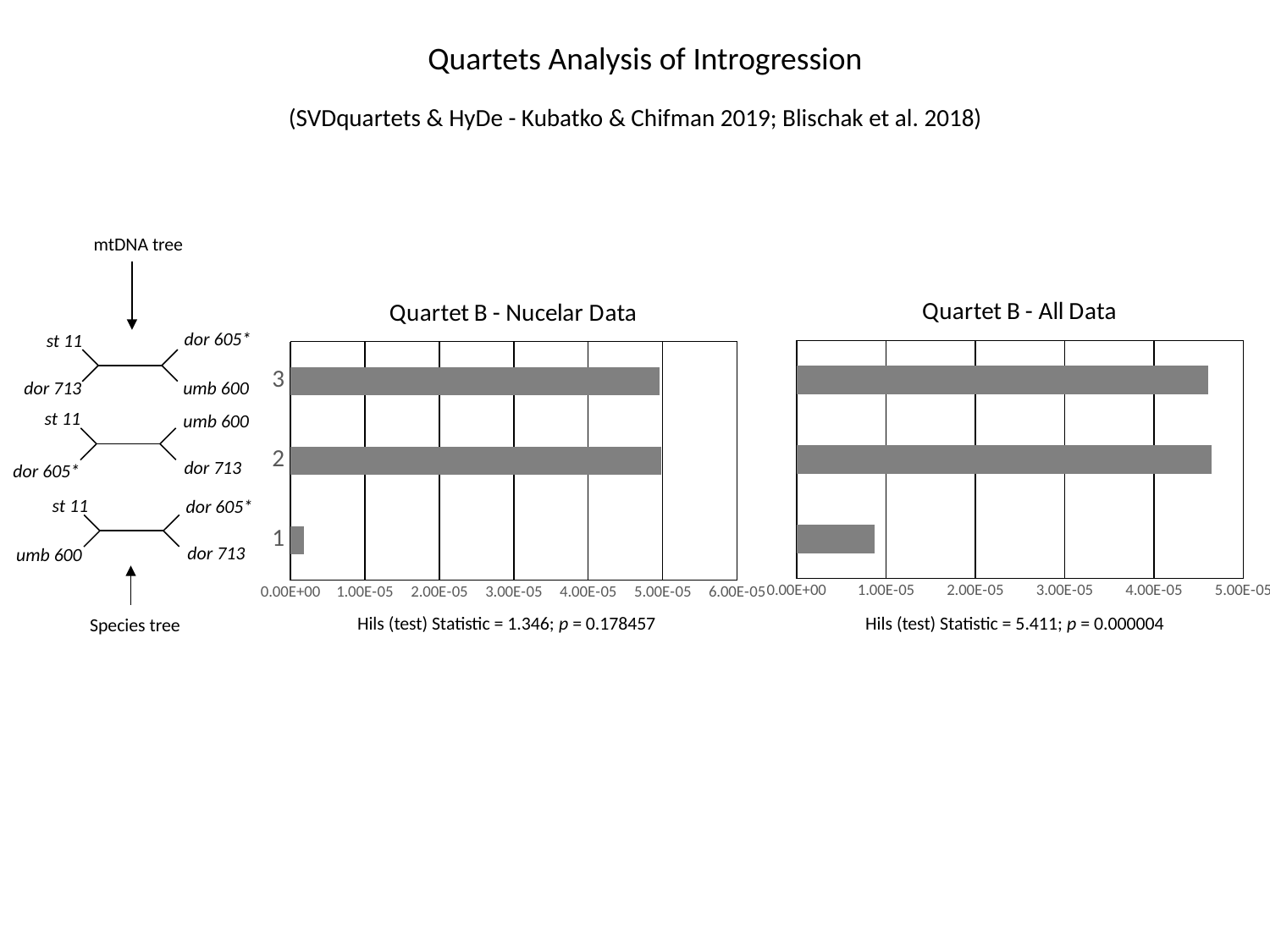
In the 'Quartet B - All Data' chart, is the value for category 1 greater or less than 2.00E-05? less How many bars are plotted in the 'Quartet B - Nucelar Data' chart? 3 In the 'Quartet B - Nucelar Data' chart, is the value for category 3 greater or less than 4.00E-05? greater How many bars are plotted in the 'Quartet B - All Data' chart? 3 In the 'Quartet B - Nucelar Data' chart, is the value for category 1 greater or less than 1.00E-05? less What is the title of the chart on the right side of the slide? Quartet B - All Data What kind of chart is the 'Quartet B - Nucelar Data' chart? bar chart In the 'Quartet B - All Data' chart, which is larger, the value for category 1 or the value for category 3? 3 In the 'Quartet B - Nucelar Data' chart, which category has the lowest value? 1 In the 'Quartet B - All Data' chart, which category has the lowest value? 1 What kind of chart is the 'Quartet B - All Data' chart? bar chart